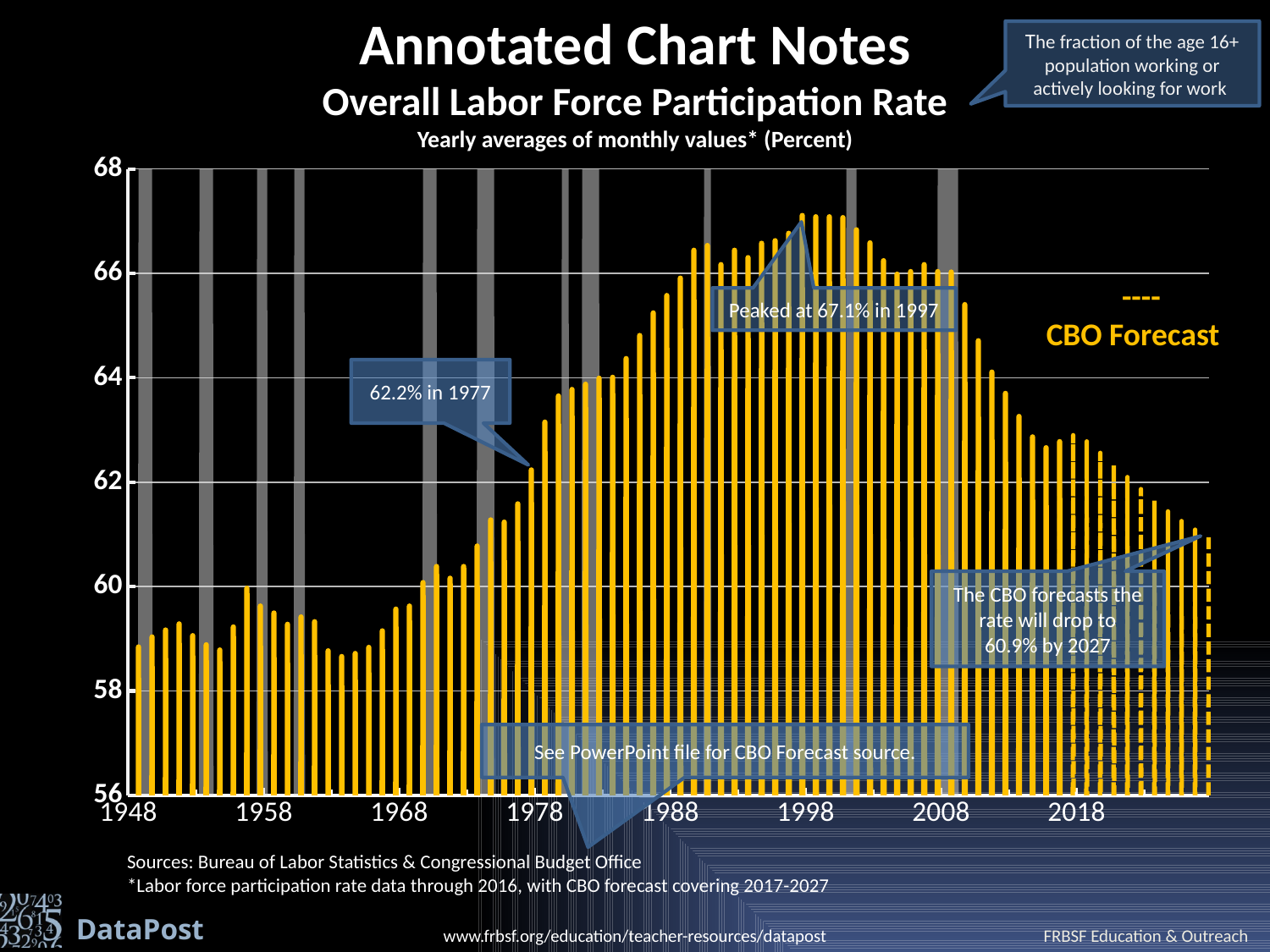
In which year did the labor force participation rate peak? 1997 Do the values rise or fall between 1977 and 1997? rise Is the value for 2018 greater or less than 64? less What do the dashed bars at the right of the chart represent, according to the legend? CBO Forecast What kind of chart is shown on the slide? bar chart Is the value for 1948 greater or less than 60? less Which is larger: the 1977 value or the 2027 forecast value? 1977 How many percentage points higher was the 1997 peak than the 1977 value? 4.9 How many percentage points lower is the 2027 forecast than the 1997 peak? 6.2 What rate does the CBO forecast for 2027? 60.9% What was the labor force participation rate in 1977, according to the annotation? 62.2% What was the peak value of the labor force participation rate shown on the chart? 67.1%